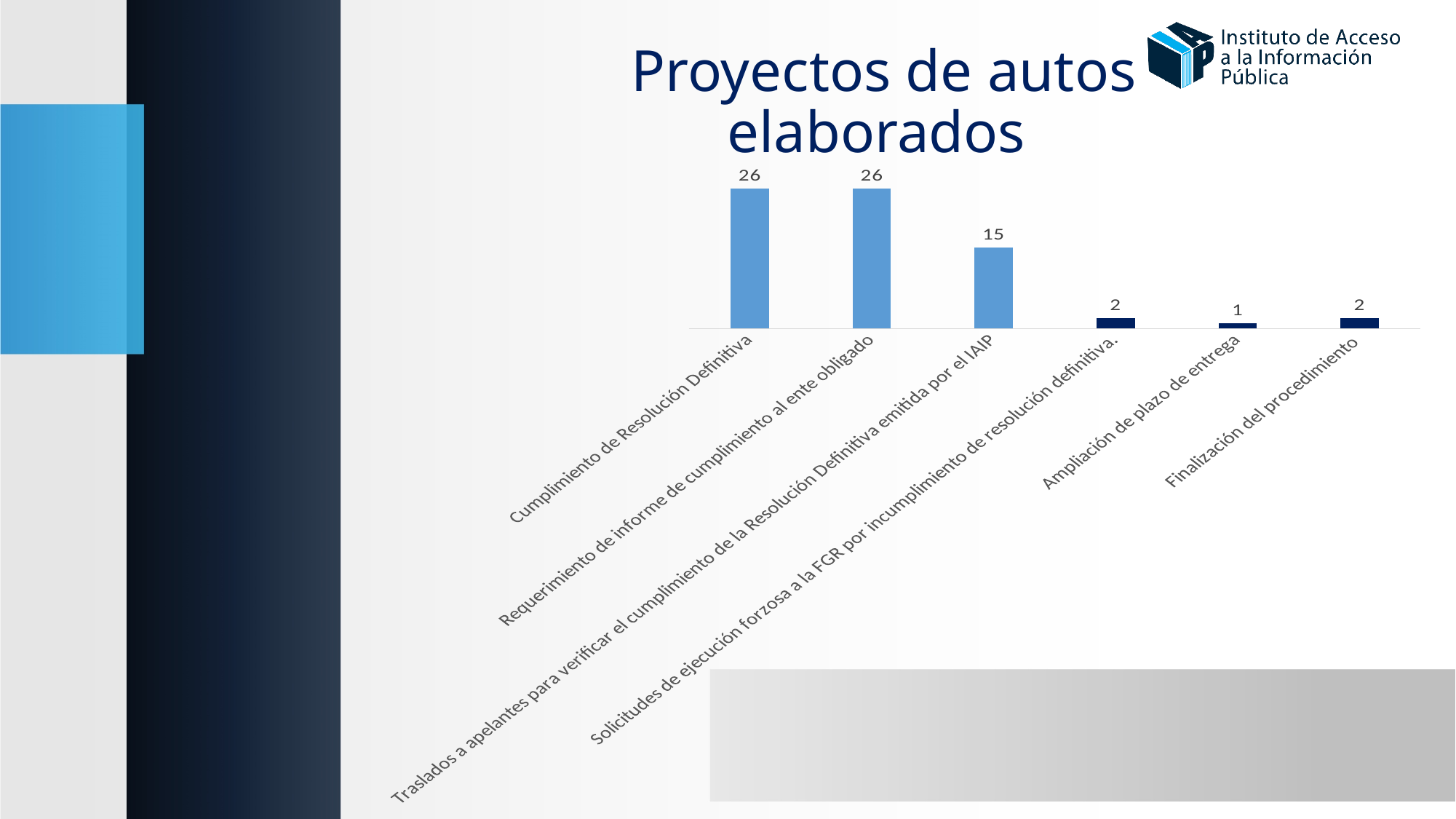
What is the value for Requerimiento de informe de cumplimiento al ente obligado? 26 What is the title of the chart? Proyectos de autos elaborados What kind of chart is shown on the slide? Bar chart What is the value for Cumplimiento de Resolución Definitiva? 26 What is the value for Finalización del procedimiento? 2 Which is larger: the value for Solicitudes de ejecución forzosa a la FGR por incumplimiento de resolución definitiva or the value for Ampliación de plazo de entrega? Solicitudes de ejecución forzosa a la FGR por incumplimiento de resolución definitiva Which category has the lowest value? Ampliación de plazo de entrega What is the value for Traslados a apelantes para verificar el cumplimiento de la Resolución Definitiva emitida por el IAIP? 15 What is the value for Ampliación de plazo de entrega? 1 What is the difference between the values for Cumplimiento de Resolución Definitiva and Traslados a apelantes para verificar el cumplimiento de la Resolución Definitiva emitida por el IAIP? 11 How many categories are shown in the chart? 6 Do the values generally rise or fall from left to right across the categories? Fall